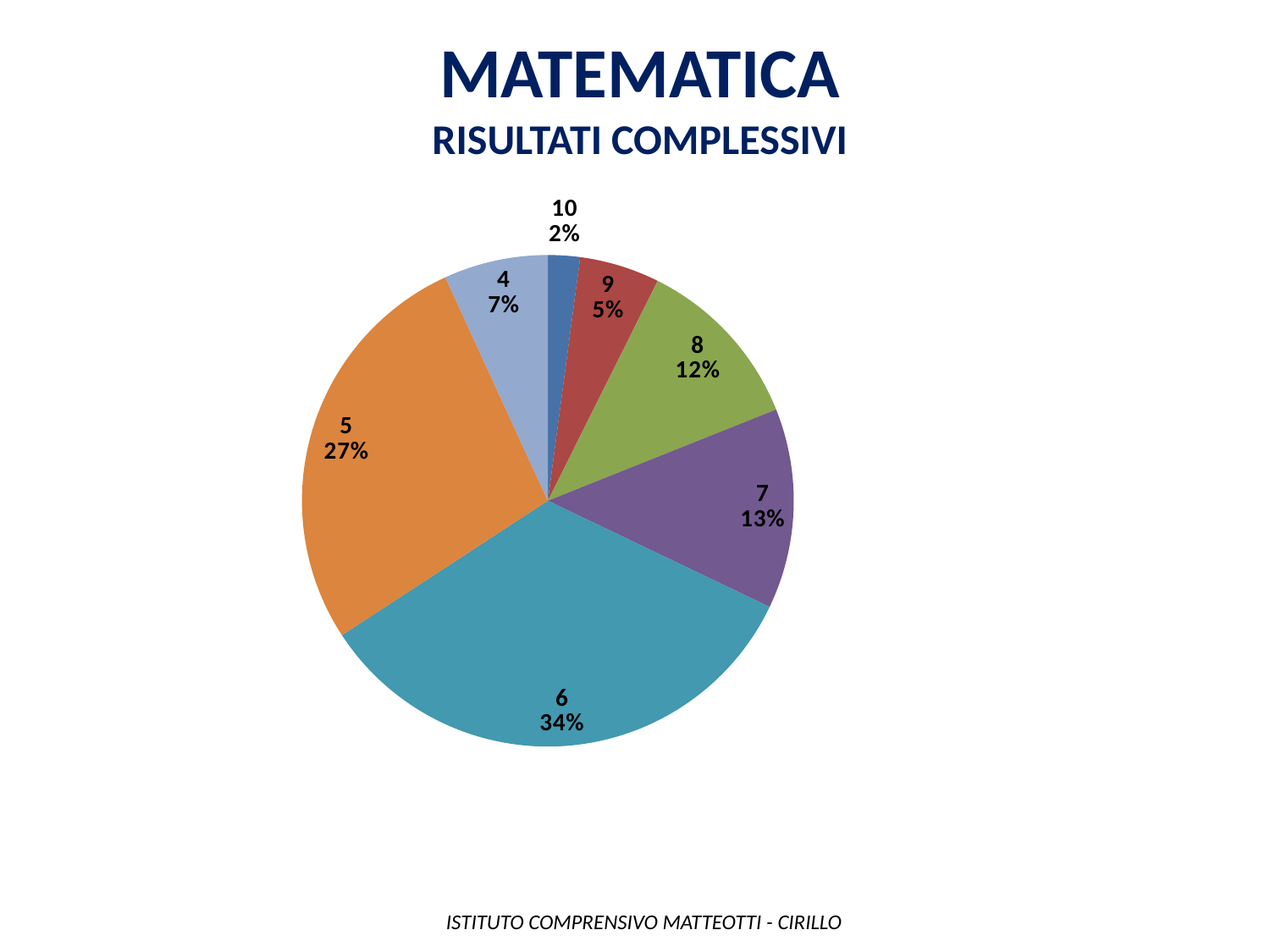
What is the difference in percentage points between grade 6 and grade 5? 7 Which has a larger share, grade 7 or grade 4? 7 What is the title of the chart? MATEMATICA RISULTATI COMPLESSIVI What is the difference in percentage points between grade 8 and grade 9? 7 Which grade has the largest slice of the pie? 6 What percentage is shown for grade 8? 12% What share of the pie does grade 6 represent? 34% What share of the pie does grade 5 represent? 27% What percentage is shown for grade 10? 2% Which grade has the smallest slice of the pie? 10 What kind of chart is shown on the slide? pie chart How many slices does the pie chart have? 7